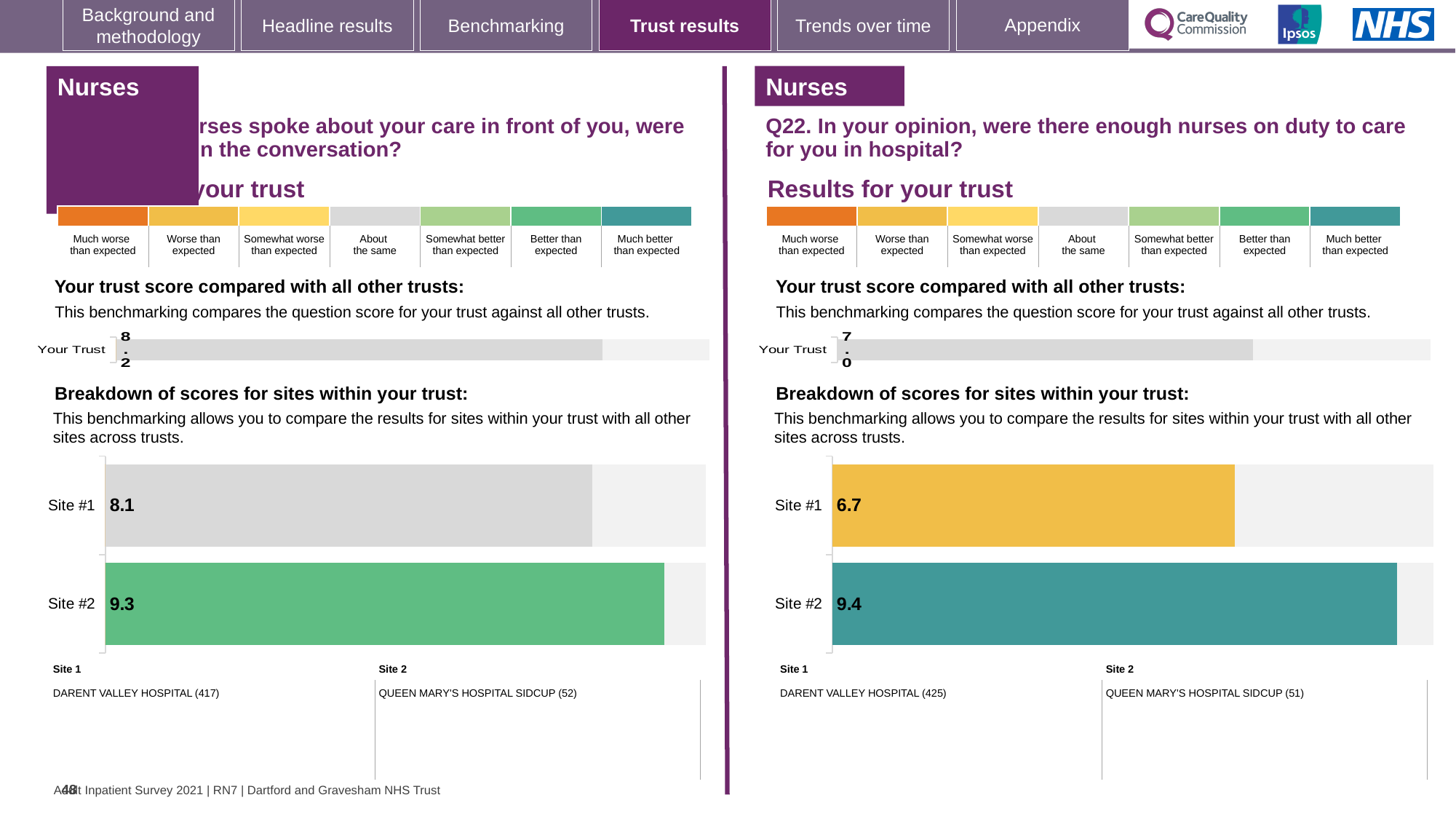
On the Q22 'Breakdown of scores for sites within your trust' chart, what is the score for Site #1? 6.7 What type of chart is the Q22 'Breakdown of scores for sites within your trust' chart? Bar chart On the Q22 site breakdown chart, which site has the higher score? Site #2 On the left-hand site breakdown chart, what is the difference between the Site #2 and Site #1 scores? 1.2 On the left-hand 'Your trust score compared with all other trusts' chart, what is the score for Your Trust? 8.2 On the Q22 'Breakdown of scores for sites within your trust' chart, what is the score for Site #2? 9.4 On the left-hand 'Breakdown of scores for sites within your trust' chart, what is the score for Site #2? 9.3 On the left-hand site breakdown chart, which site has the lower score? Site #1 On the Q22 site breakdown chart, what is the difference between the Site #2 and Site #1 scores? 2.7 On the left-hand 'Breakdown of scores for sites within your trust' chart, what is the score for Site #1? 8.1 On the Q22 'Your trust score compared with all other trusts' chart, what is the score for Your Trust? 7.0 How many sites are shown on the Q22 site breakdown chart? 2